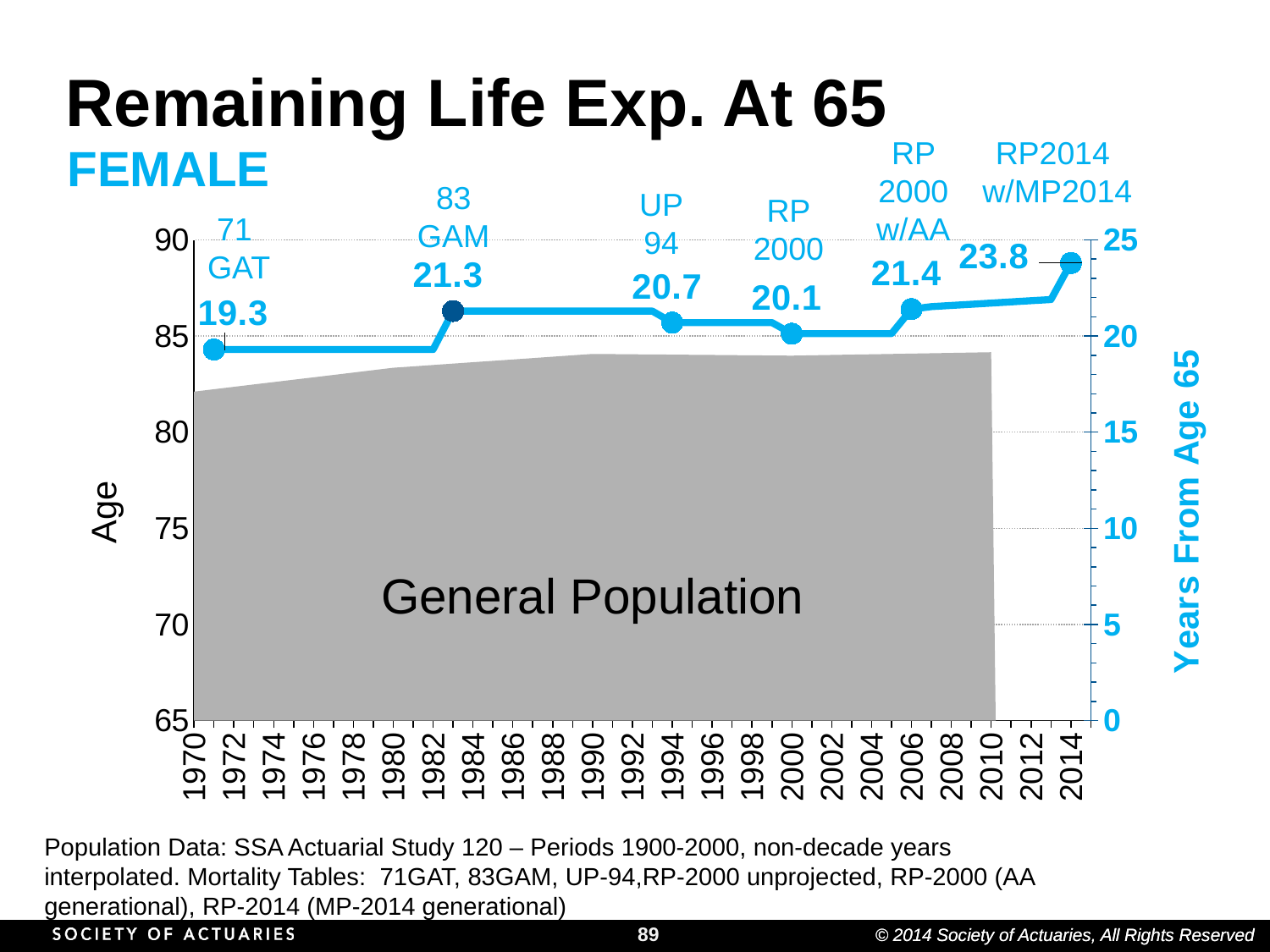
What is the difference between the RP2014 w/MP2014 value and the 71 GAT value? 4.5 What is the remaining life expectancy value shown for the 71 GAT mortality table? 19.3 Which mortality table has the highest labeled value on the line? RP2014 w/MP2014 How many labeled data points are on the mortality table line? 6 Which mortality table has the lowest labeled value on the line? 71 GAT What is the title of the right-hand vertical axis? Years From Age 65 What value is shown for RP2014 w/MP2014? 23.8 What value is shown for the RP 2000 table? 20.1 What value is labeled for the 83 GAM point on the line? 21.3 What value is shown for the UP 94 table? 20.7 Which is larger, the value for RP 2000 w/AA or the value for UP 94? RP 2000 w/AA What label is printed on the gray shaded area of the chart? General Population